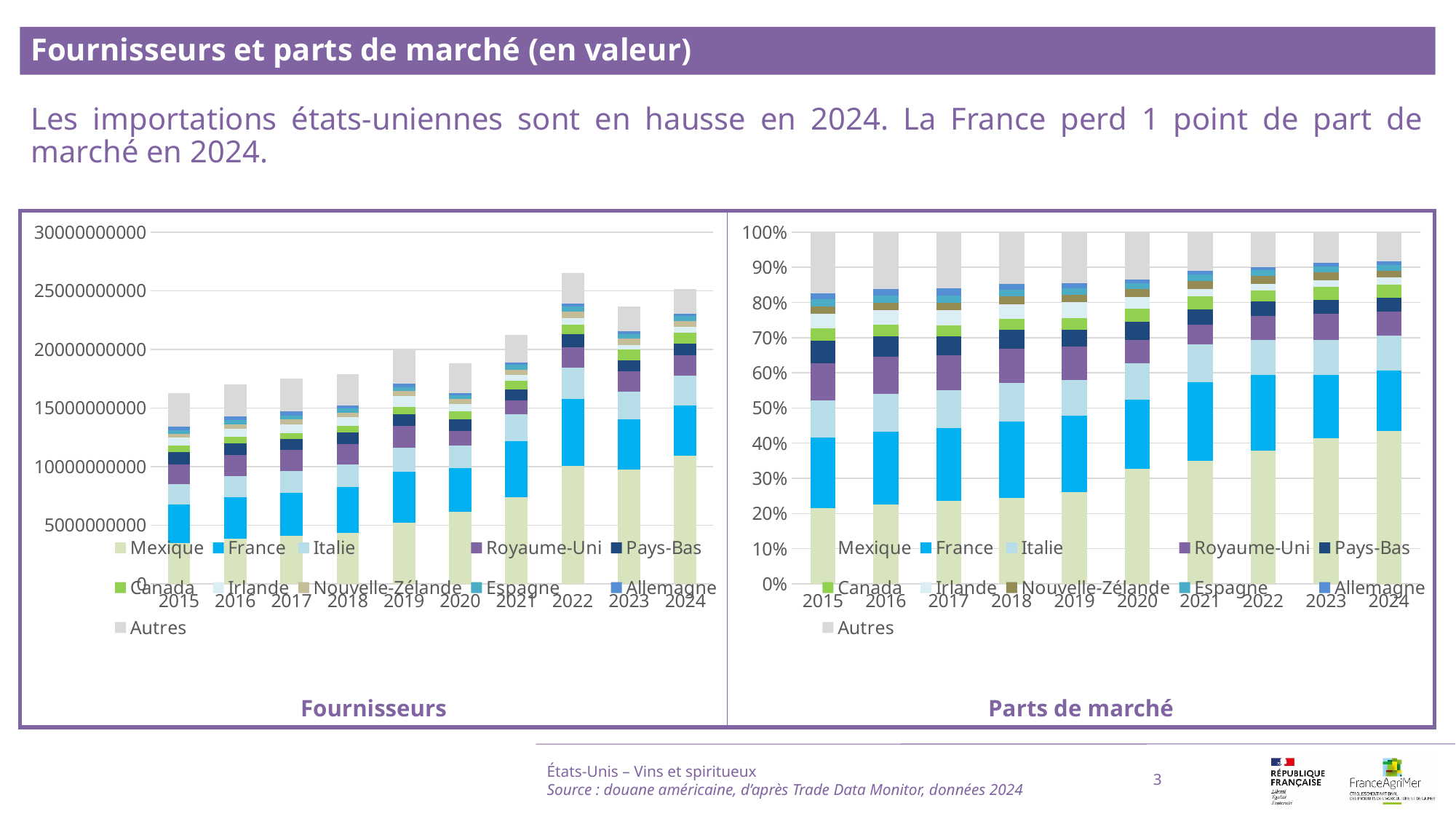
In the 'Parts de marché' chart, is the share of Mexique in 2015 greater or less than 30%? less In the 'Fournisseurs' chart, is the total for 2023 greater or less than 25000000000? less How many series does the legend of the 'Fournisseurs' chart list? 11 Which series is listed first in the legend of the 'Fournisseurs' chart? Mexique In the 'Fournisseurs' chart, is the total for 2022 greater or less than 25000000000? greater In the 'Fournisseurs' chart, which year has the lowest total bar? 2015 In the 'Fournisseurs' chart, which year has the highest total bar? 2022 How many years are shown on the x axis of the 'Parts de marché' chart? 10 In the 'Parts de marché' chart, does the share of Mexique rise or fall from 2015 to 2024? rise What kind of chart is the 'Fournisseurs' chart on the left? stacked bar chart